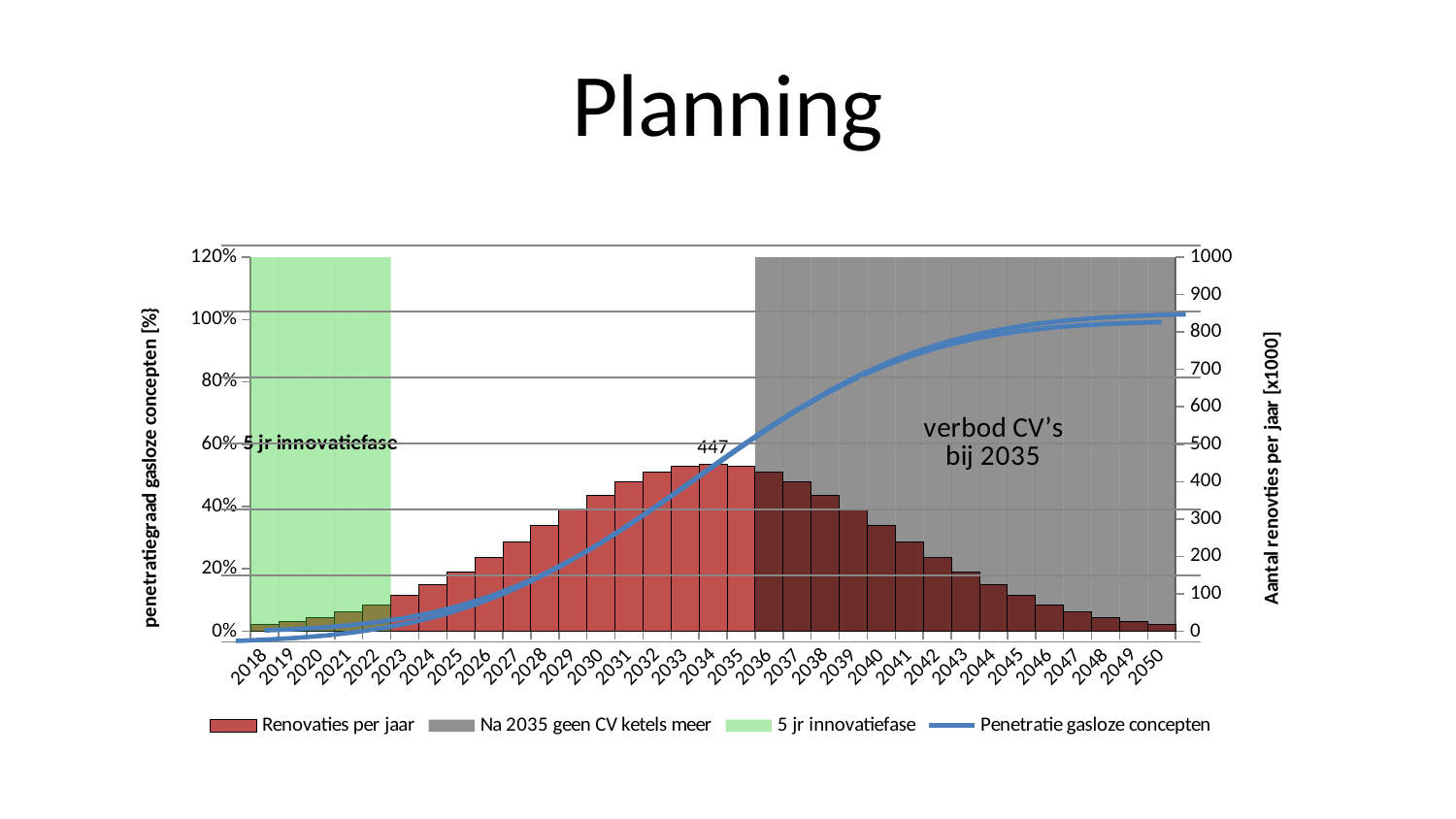
In which year do the Renovaties per jaar bars reach their highest value? 2034 Does the Penetratie gasloze concepten line rise or fall from 2018 to 2050? Rises How many years are shown on the x axis? 33 Is the Renovaties per jaar value for 2050 greater or less than 100? less Is the Penetratie gasloze concepten value for 2030 greater or less than 40%? less Is the Renovaties per jaar value for 2030 greater or less than 300? greater Which year has more Renovaties per jaar, 2028 or 2042? 2028 How many entries does the legend list? 4 What is the label of the right-hand vertical axis? Aantal renovties per jaar [x1000] What kind of chart is shown on the slide? Combination bar and line chart Which legend entry corresponds to the green shaded area? 5 jr innovatiefase What is the labelled value of Renovaties per jaar in 2034? 447